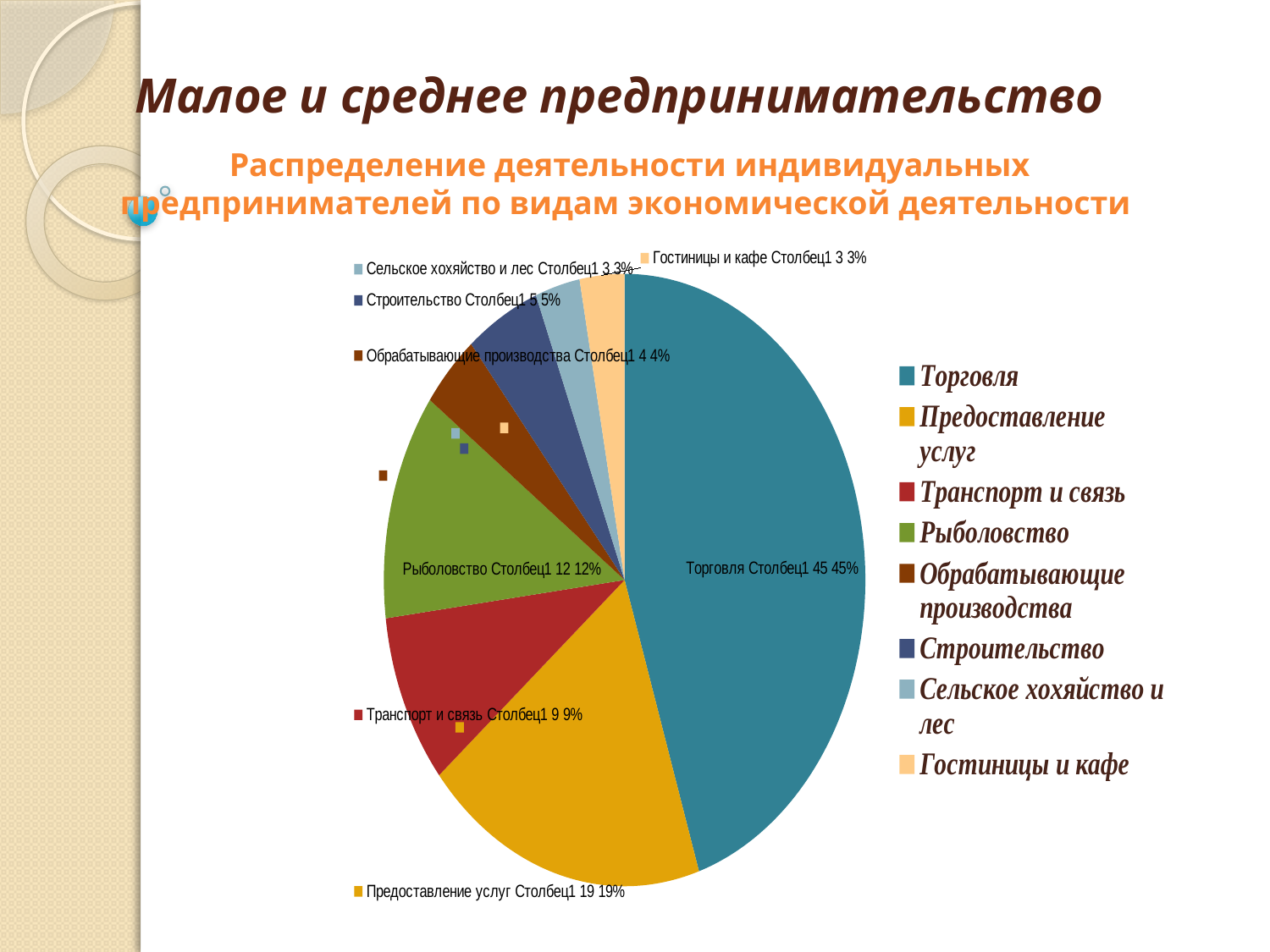
What share of the pie does Торговля account for? 45% What colour is the slice for Предоставление услуг? yellow What share of the pie does Рыболовство account for? 12% What share of the pie does Строительство account for? 5% What kind of chart is shown on the slide? pie chart How many categories does the legend list? 8 Which category has the largest slice of the pie? Торговля What is the difference in percentage points between the Торговля slice and the Предоставление услуг slice? 26 Which is larger, the slice for Рыболовство or the slice for Транспорт и связь? Рыболовство